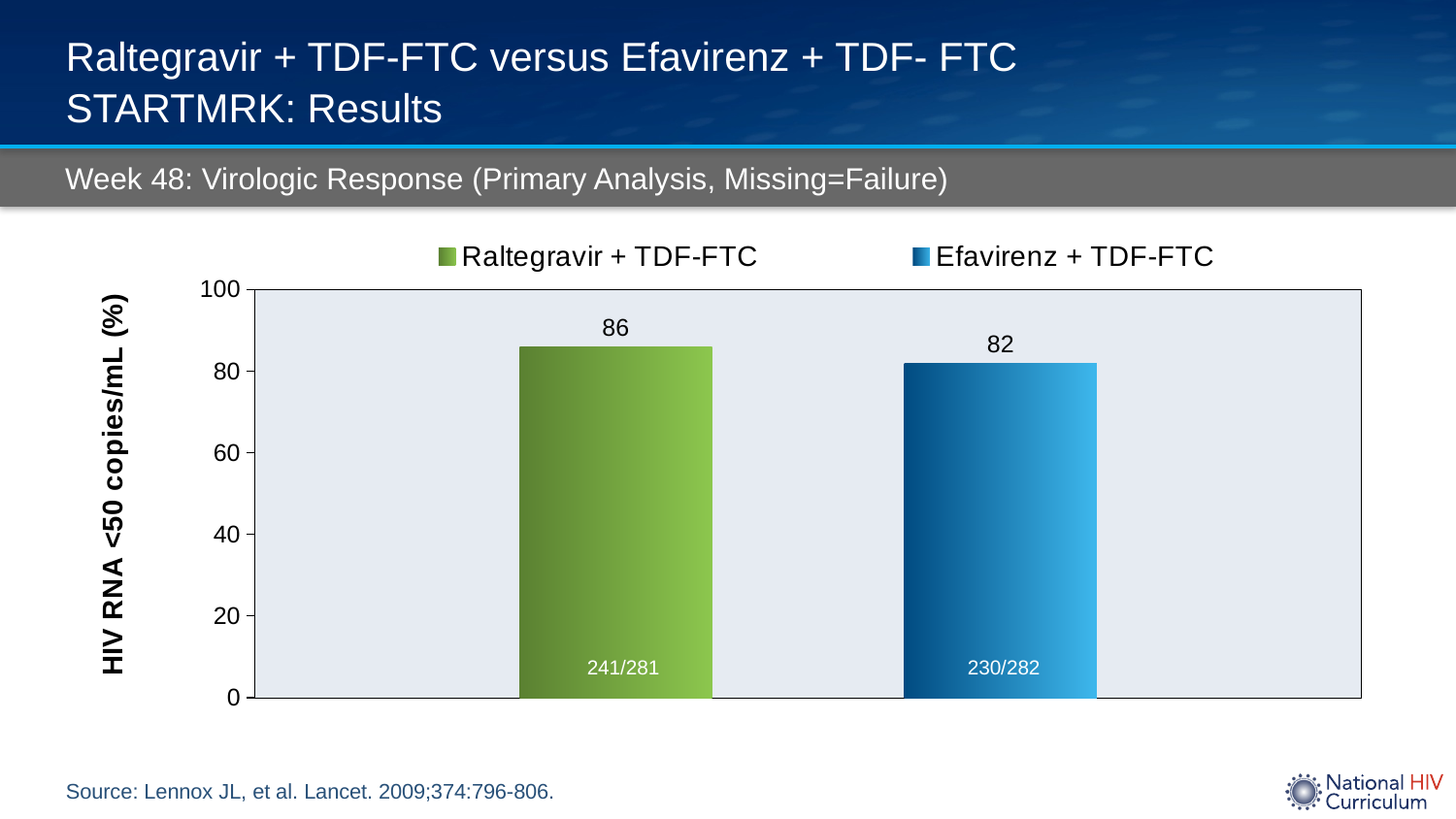
How many series does the legend list? 2 How many bars are plotted on the chart? 2 What is the difference between the Raltegravir + TDF-FTC and Efavirenz + TDF-FTC values? 4 What fraction is printed inside the Raltegravir + TDF-FTC bar? 241/281 Is the value for Efavirenz + TDF-FTC greater or less than 60? greater What kind of chart is shown on the slide? bar chart What is the label of the y axis? HIV RNA <50 copies/mL (%) What is the value for Efavirenz + TDF-FTC? 82 What is the value for Raltegravir + TDF-FTC? 86 Which group has the higher percentage with HIV RNA <50 copies/mL? Raltegravir + TDF-FTC Is the value for Raltegravir + TDF-FTC larger or smaller than the value for Efavirenz + TDF-FTC? larger Which group has the lower percentage with HIV RNA <50 copies/mL? Efavirenz + TDF-FTC